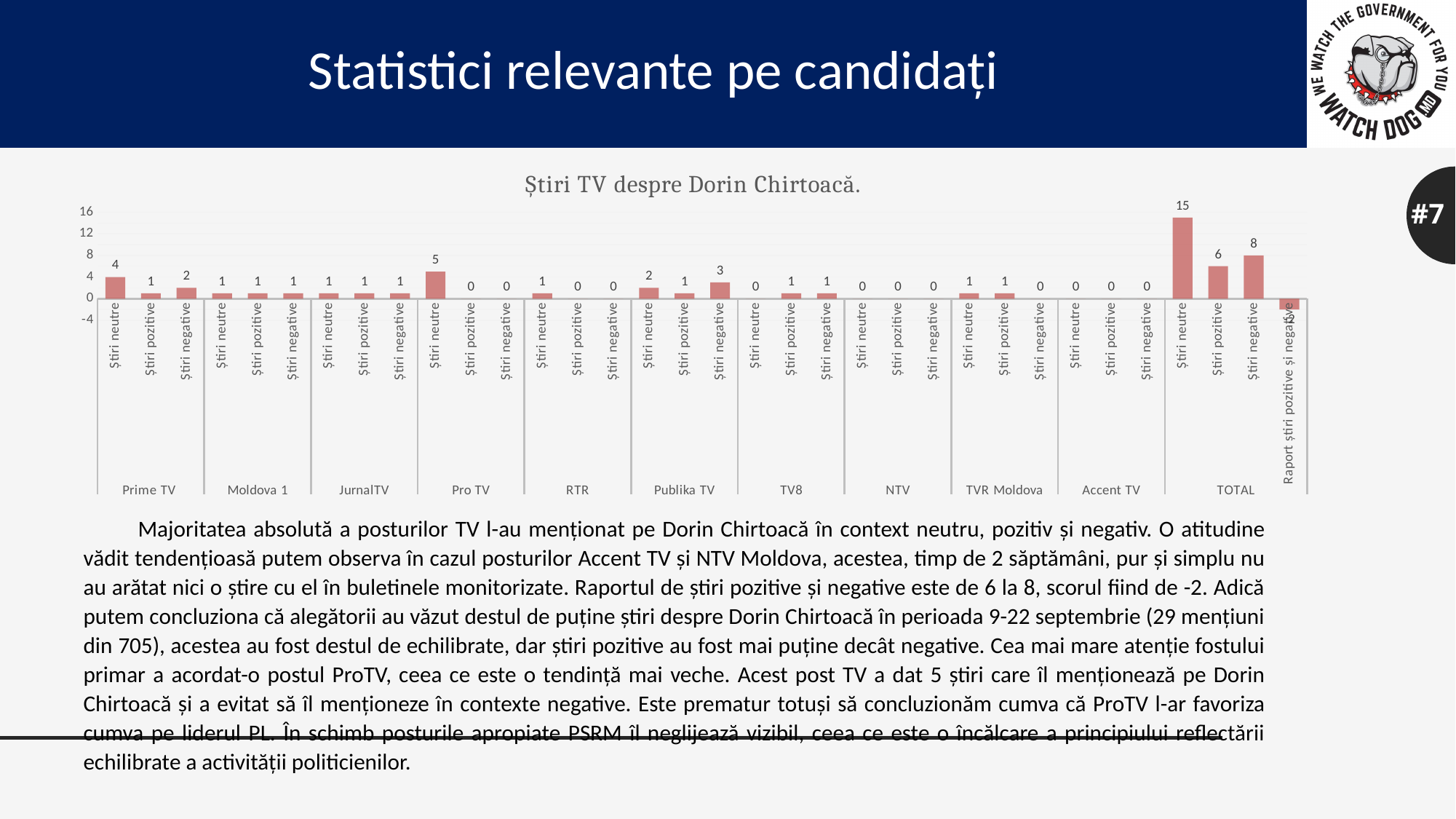
Which TV station has the highest number of neutral news items (Știri neutre), excluding TOTAL? Pro TV What kind of chart is shown on the slide? bar chart Is the TOTAL value for Știri neutre greater or less than 12? greater How many TV stations are shown on the x axis, excluding the TOTAL group? 10 What is the TOTAL value for Știri negative? 8 What is the difference between the TOTAL Știri negative and TOTAL Știri pozitive values? 2 Which is larger: Știri neutre for Prime TV or Știri neutre for Publika TV? Prime TV What is the TOTAL value for Știri pozitive? 6 How many neutral news items (Știri neutre) did Prime TV have about Dorin Chirtoacă? 4 What is the value for Știri negative at Publika TV? 3 How many neutral news items (Știri neutre) did Pro TV have? 5 What is the title of the chart? Știri TV despre Dorin Chirtoacă.